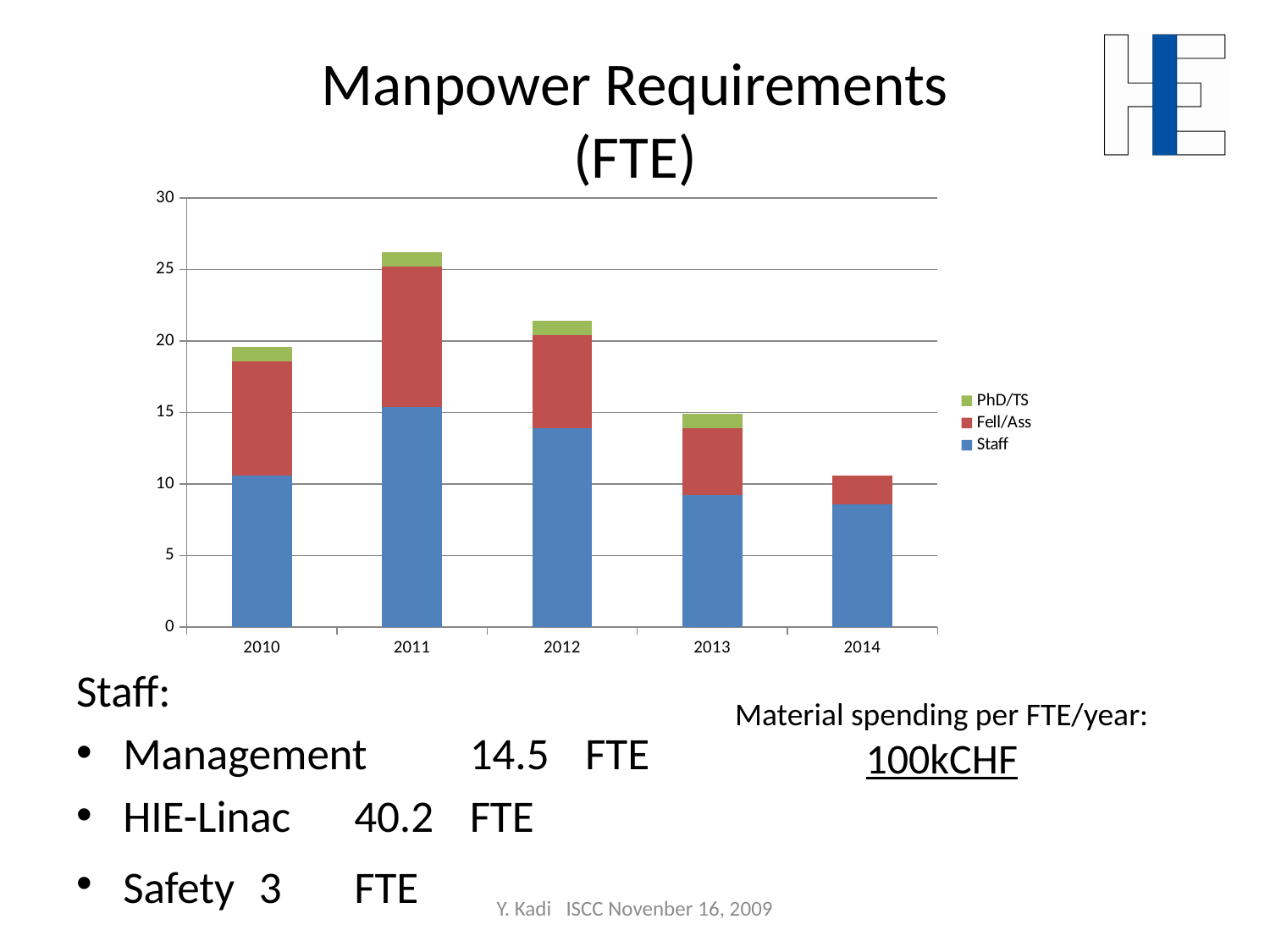
How many years are shown on the x axis of the chart? 5 Which year has the larger total bar, 2010 or 2013? 2010 Which year has the larger Staff value, 2011 or 2012? 2011 Do the total bar heights rise or fall from 2011 to 2014? fall Which year has the shortest total bar in the chart? 2014 Is the total value for 2012 greater or less than 20? greater Is the total value for 2011 greater or less than 25? greater Which year has the tallest total bar in the chart? 2011 How many series does the chart's legend list? 3 Is the Staff value for 2014 greater or less than 10? less What kind of chart is shown on the slide? bar chart What are the three series listed in the chart's legend? PhD/TS, Fell/Ass, Staff